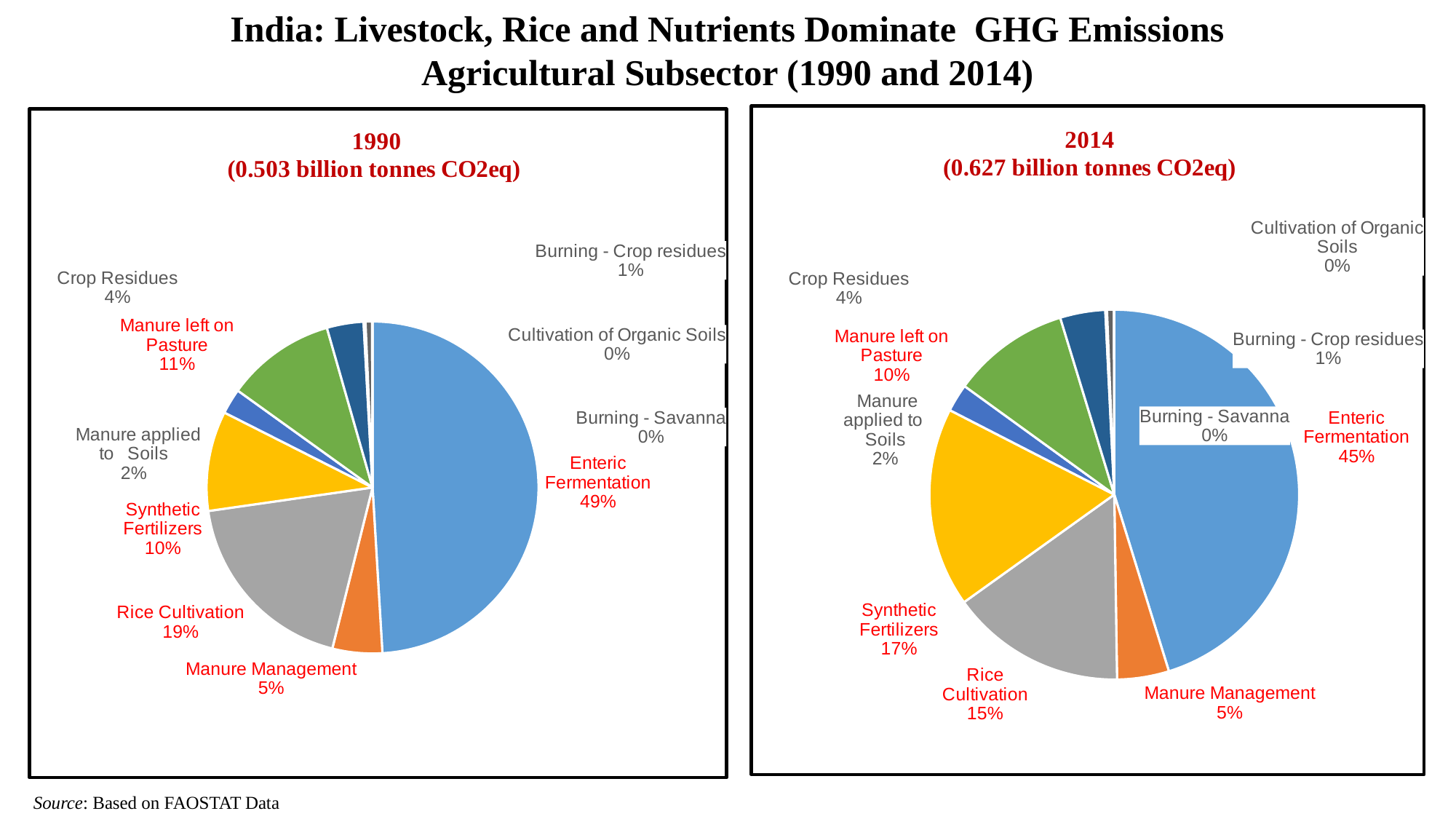
In the 2014 chart, what share of emissions comes from Synthetic Fertilizers? 17% What total emissions figure is given in the title of the 2014 chart? 0.627 billion tonnes CO2eq In the 1990 chart, which is larger: Rice Cultivation or Synthetic Fertilizers? Rice Cultivation How many categories are labelled in the 2014 pie chart? 10 In the 1990 chart, what share of emissions comes from Enteric Fermentation? 49% In the 2014 chart, which category has the largest share? Enteric Fermentation In the 2014 chart, what share of emissions comes from Rice Cultivation? 15% What is the difference between the Enteric Fermentation share in 1990 and in 2014? 4 percentage points In the 1990 chart, what is the difference between the Rice Cultivation share and the Manure Management share? 14 percentage points In the 2014 chart, which is larger: Synthetic Fertilizers or Rice Cultivation? Synthetic Fertilizers What type of charts are shown on the slide? Pie charts In the 1990 chart, what share of emissions comes from Manure left on Pasture? 11%